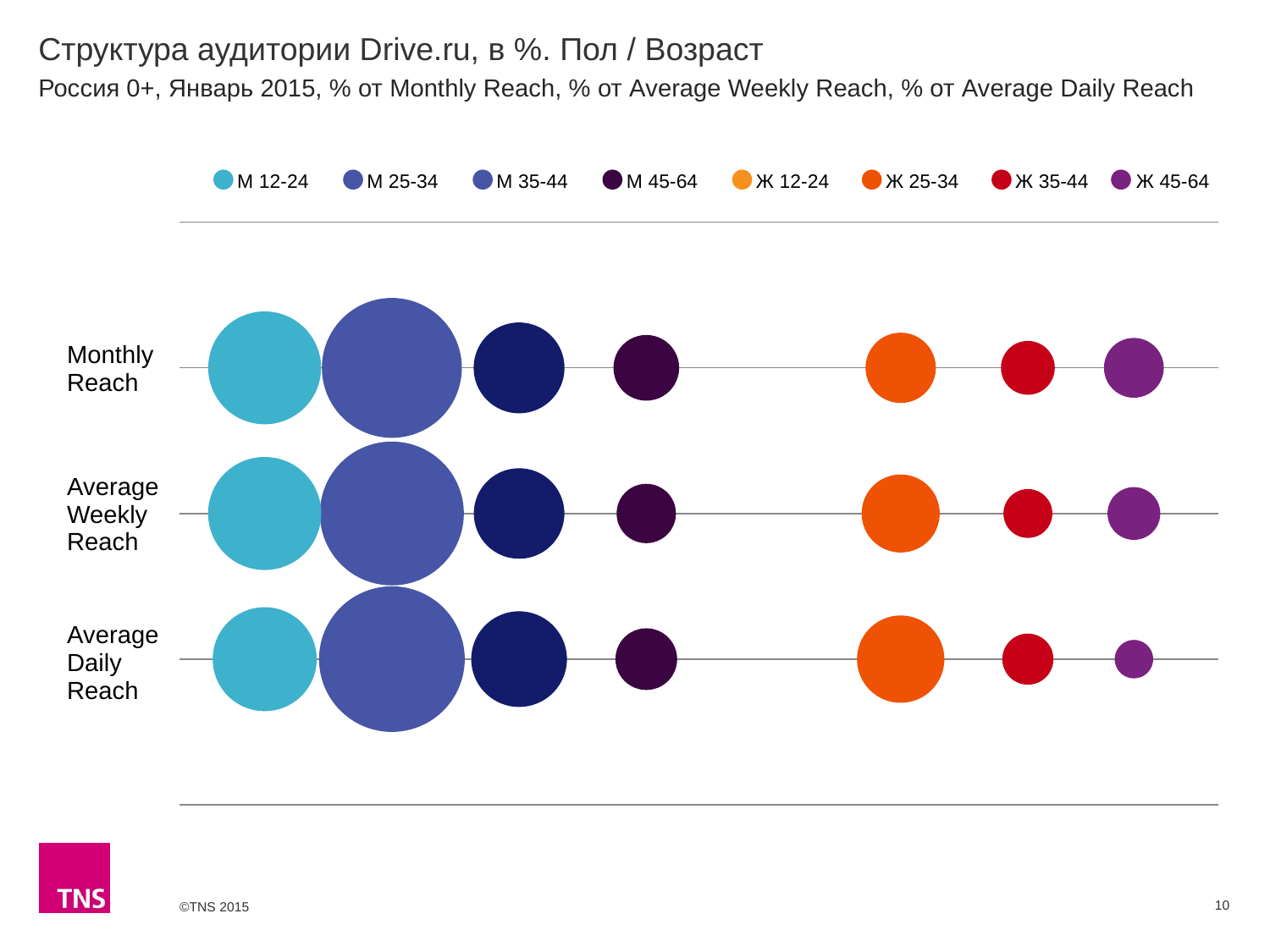
In the Average Daily Reach row, which bubble is larger: Ж 25-34 or Ж 35-44? Ж 25-34 How many series does the legend list? 8 What is the title of the slide? Структура аудитории Drive.ru, в %. Пол / Возраст Which series has the largest bubble in the Average Daily Reach row? М 25-34 Which series has the smallest bubble in the Average Daily Reach row? Ж 45-64 Which legend series has no visible bubble in any row of the chart? Ж 12-24 What kind of chart is shown on the slide? bubble chart Which series has the largest bubble in the Monthly Reach row? М 25-34 Does the Ж 45-64 bubble get larger or smaller going from Monthly Reach to Average Daily Reach? smaller How many reach categories (rows) are plotted on the chart? 3 In the Monthly Reach row, which bubble is larger: М 12-24 or М 45-64? М 12-24